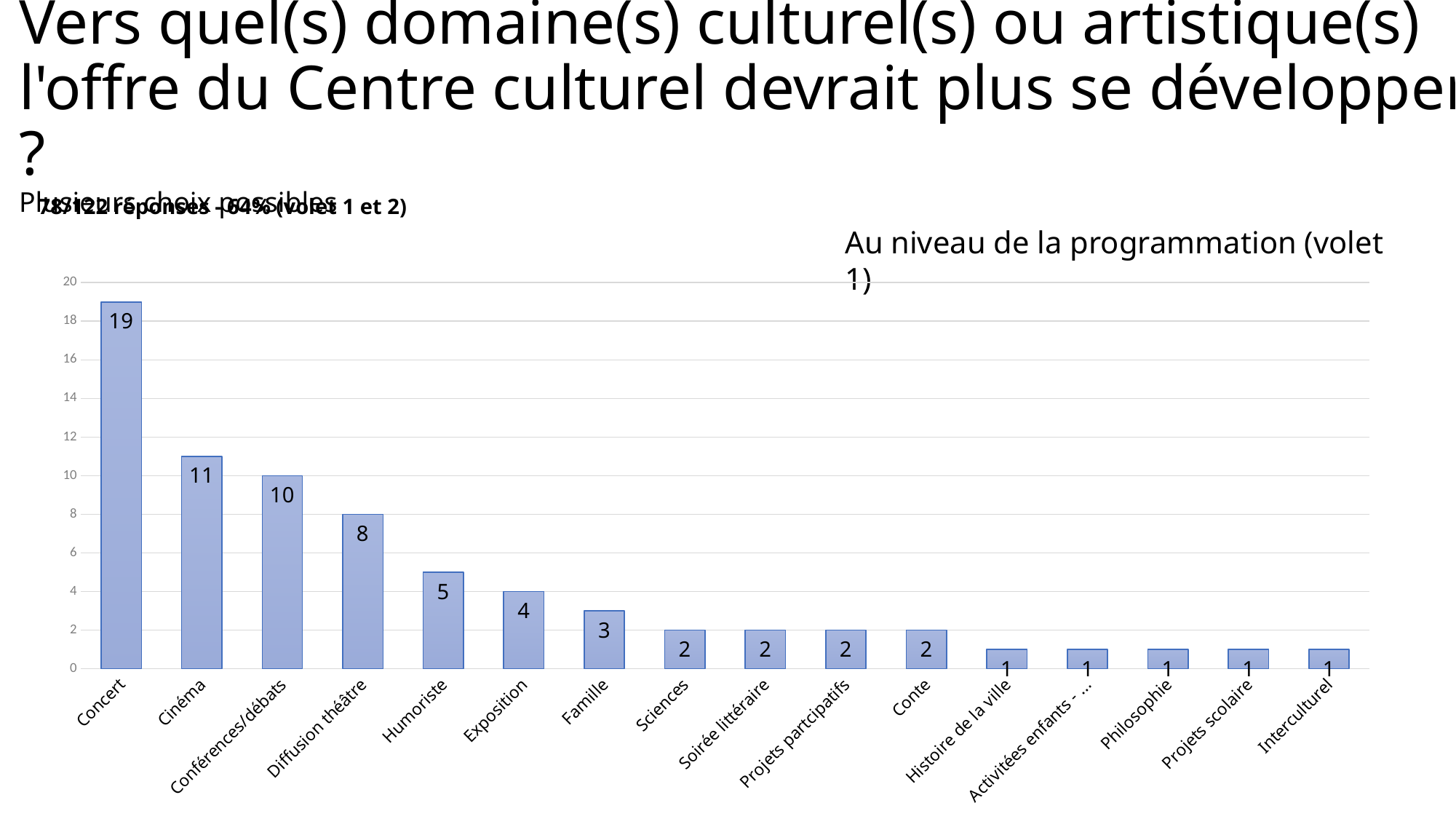
Which category has the highest value? Concert What is the value for Diffusion théatre? 8 Is the value for Concert greater or less than 16? greater What kind of chart is shown on the slide? bar chart What is the value for Famille? 3 What is the difference between the values for Conférences/débats and Exposition? 6 What is the value for Concert? 19 What is the value for Cinéma? 11 How many categories are shown on the x axis? 16 What is the value for Humoriste? 5 Which is larger, the value for Cinéma or the value for Diffusion théatre? Cinéma What is the difference between the values for Concert and Cinéma? 8